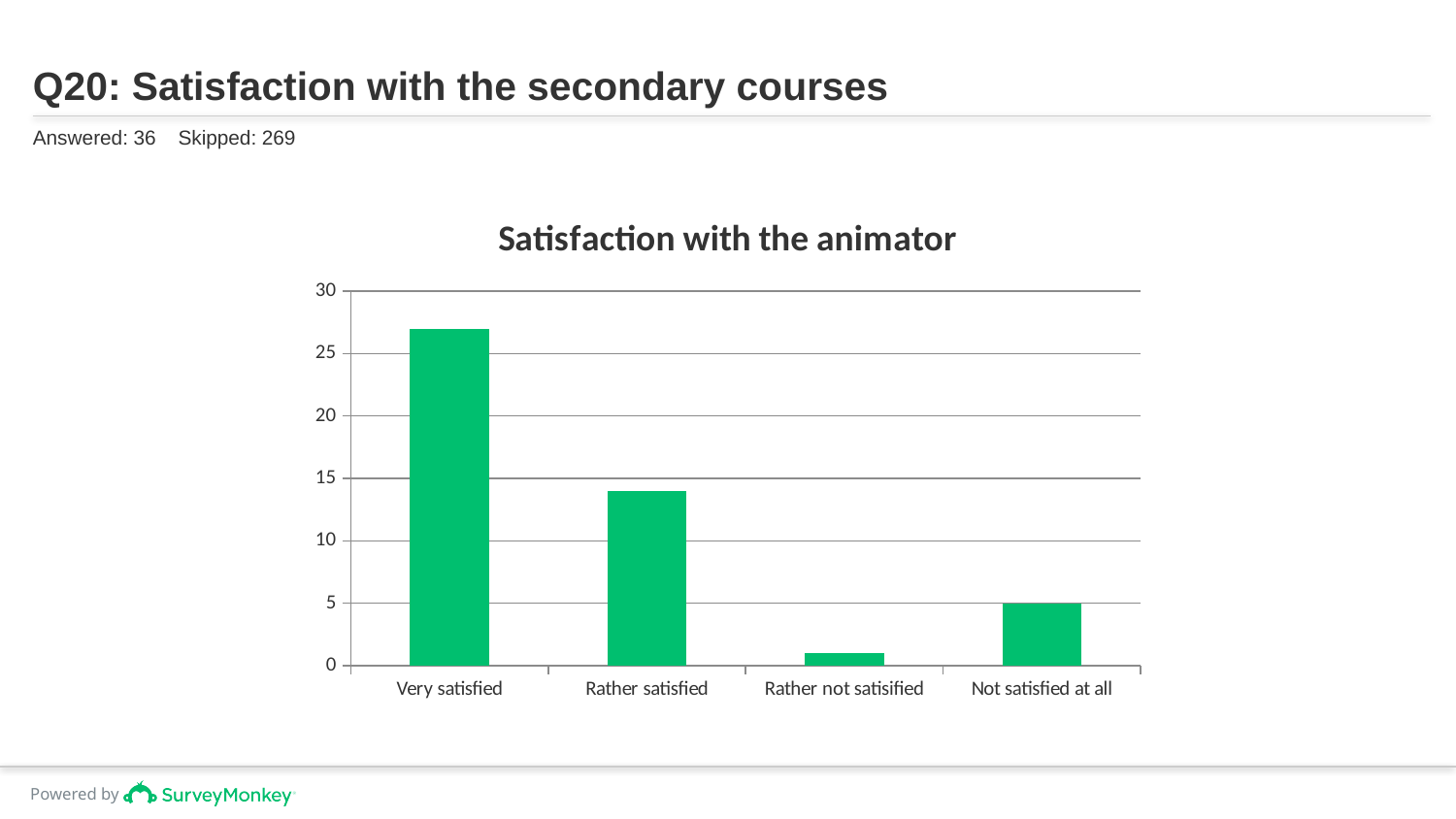
Which category has the highest value? Very satisfied What colour are the bars in the chart? green Which category has the lowest value? Rather not satisified Is the value for Rather not satisified greater or less than 5? less Is the value for Very satisfied greater or less than 25? greater What kind of chart is shown on the slide? bar chart Do the values generally rise or fall from Very satisfied to Rather not satisified along the x axis? fall How many categories are shown on the x axis of the chart? 4 Which is larger, the value for Rather satisfied or the value for Not satisfied at all? Rather satisfied What is the value for Not satisfied at all? 5 What is the title of the chart? Satisfaction with the animator Is the value for Rather satisfied greater or less than 15? less